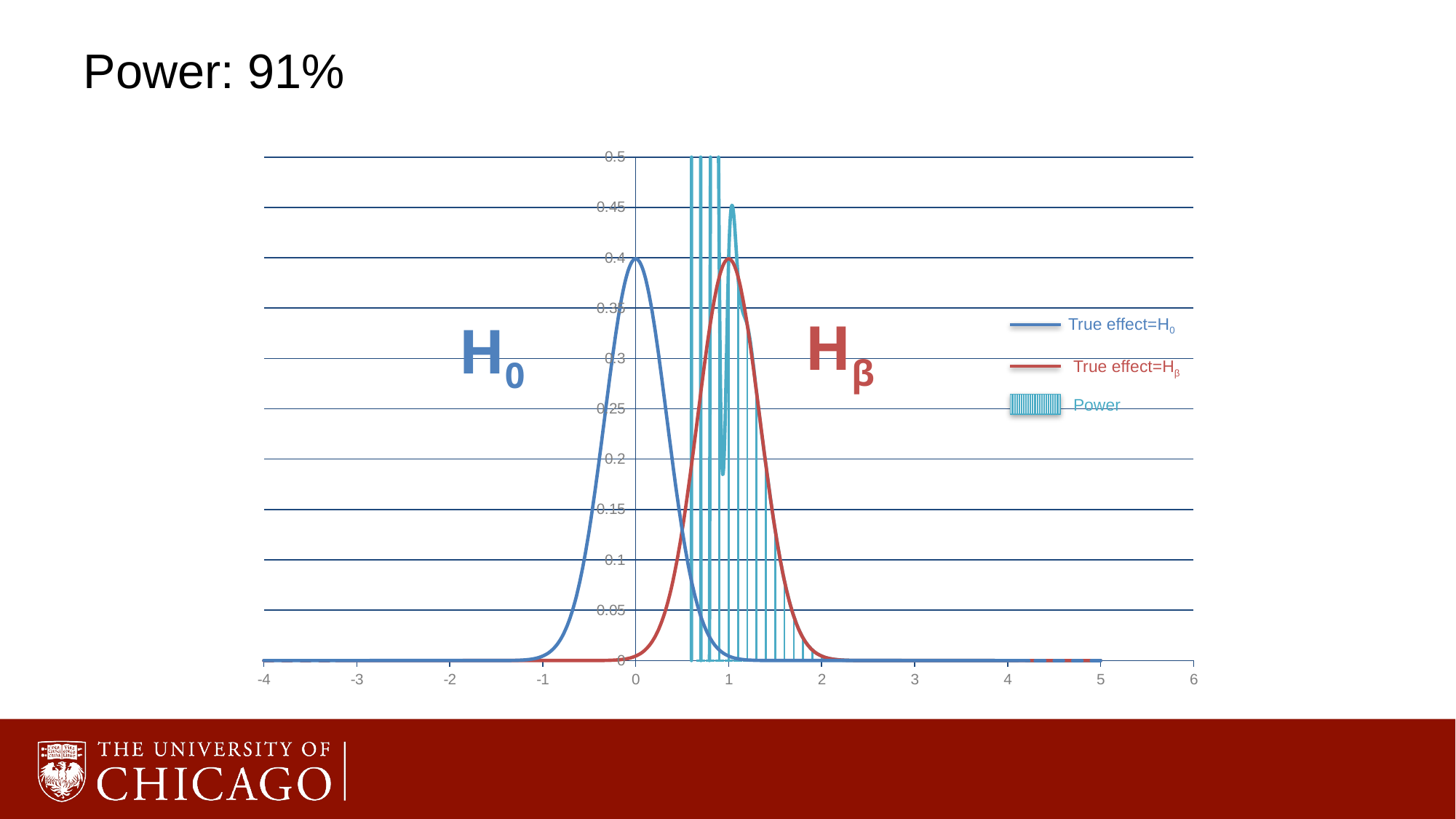
At x = 1.5, which curve is higher, the blue H0 curve or the red Hβ curve? the red Hβ curve At which x value does the red Hβ curve reach its peak? 1 How many entries does the chart legend list? 3 What kind of chart is shown on the slide? line chart What is the highest value shown on the chart's vertical axis? 0.5 At which x value does the blue H0 curve reach its peak? 0 What are the three legend entries of the chart? True effect=H0, True effect=Hβ, Power What colour is the curve labelled True effect=H0? blue Is the peak value of the blue H0 curve greater or less than 0.3? greater Is the value of the red Hβ curve at x = 0 greater or less than 0.1? less At x = 0, which curve is higher, the blue H0 curve or the red Hβ curve? the blue H0 curve Does the blue H0 curve rise or fall as x goes from 0 to 2? fall